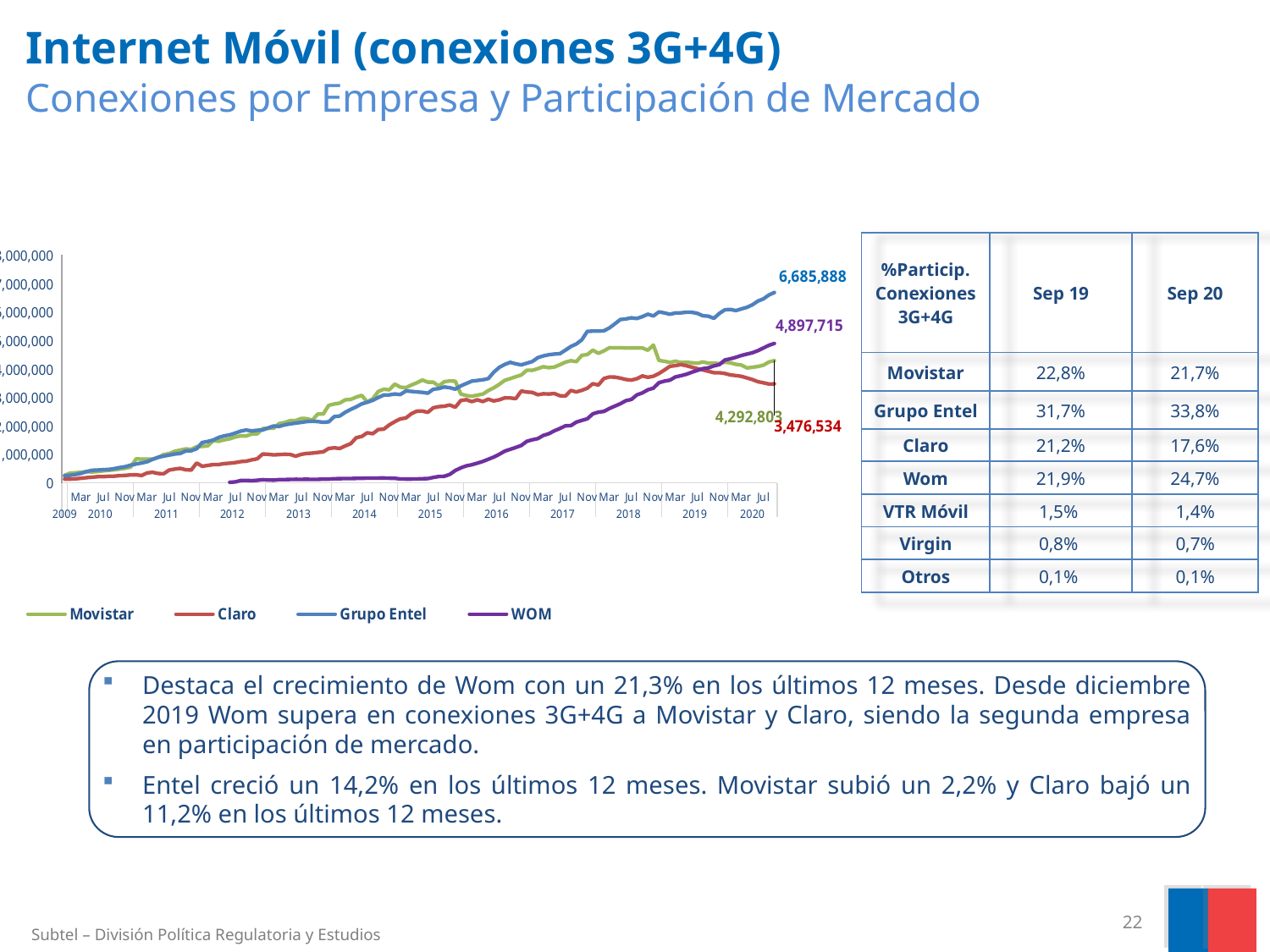
Which series has the lowest value at the end of the chart? Claro Does the WOM line rise or fall from 2015 to 2020? rises What is the final labelled value for WOM on the chart? 4,897,715 How many series does the chart legend list? 4 What is the final labelled value for Movistar on the chart? 4,292,803 What is the difference between the final values of Grupo Entel and WOM? 1,788,173 At the end of the chart, which is larger: WOM or Movistar? WOM What is the final labelled value for Grupo Entel on the chart? 6,685,888 What kind of chart is shown on the slide? line chart What is the difference between the final values of Movistar and Claro? 816,269 Which series has the highest value at the end of the chart? Grupo Entel What is the final labelled value for Claro on the chart? 3,476,534